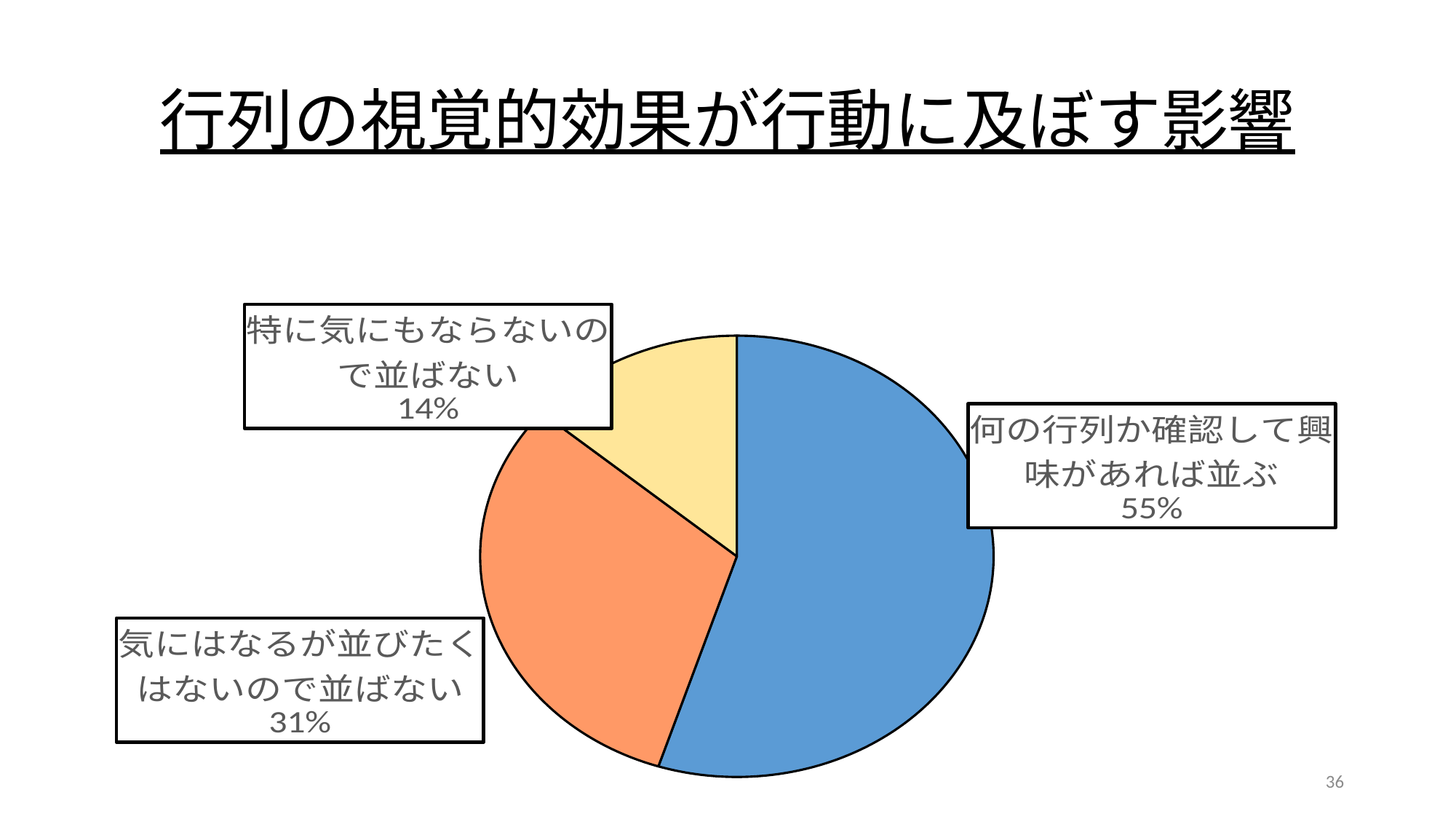
What is the difference in percentage points between the 気にはなるが並びたくはないので並ばない slice and the 特に気にもならないので並ばない slice? 17 What kind of chart is shown on the slide? pie chart What colour is the slice labelled 何の行列か確認して興味があれば並ぶ? blue What percentage of the pie is labelled 気にはなるが並びたくはないので並ばない? 31% What percentage of the pie is labelled 特に気にもならないので並ばない? 14% What percentage of the pie is labelled 何の行列か確認して興味があれば並ぶ? 55% What is the difference in percentage points between the 何の行列か確認して興味があれば並ぶ slice and the 気にはなるが並びたくはないので並ばない slice? 24 Which slice of the pie is the largest? 何の行列か確認して興味があれば並ぶ Which is larger: the 気にはなるが並びたくはないので並ばない slice or the 特に気にもならないので並ばない slice? 気にはなるが並びたくはないので並ばない Which slice of the pie is the smallest? 特に気にもならないので並ばない What is the title of the slide containing the pie chart? 行列の視覚的効果が行動に及ぼす影響 How many slices does the pie chart have? 3